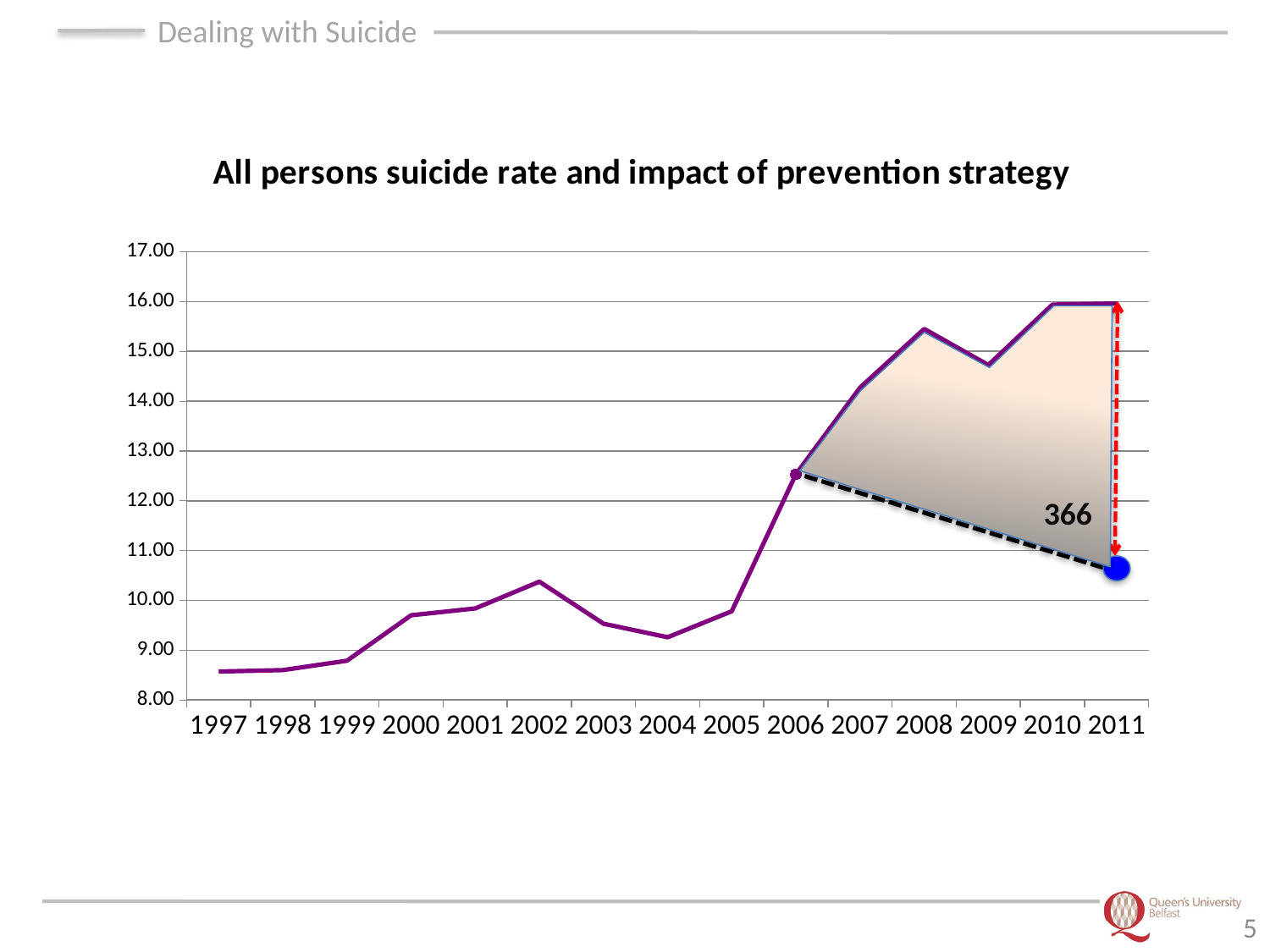
Is the value for 2004 greater or less than 10.00? less Which year has the higher value, 2002 or 2003? 2002 Is the value for 2009 greater or less than 15.00? less What kind of chart is shown on the slide? line chart What number is printed inside the shaded area of the chart? 366 Does the suicide rate rise or fall between 2005 and 2008? rise Is the value for 2006 greater or less than 12.00? greater What is the title of the chart? All persons suicide rate and impact of prevention strategy Which year has the higher value, 2008 or 2009? 2008 How many years are shown on the x axis of the chart? 15